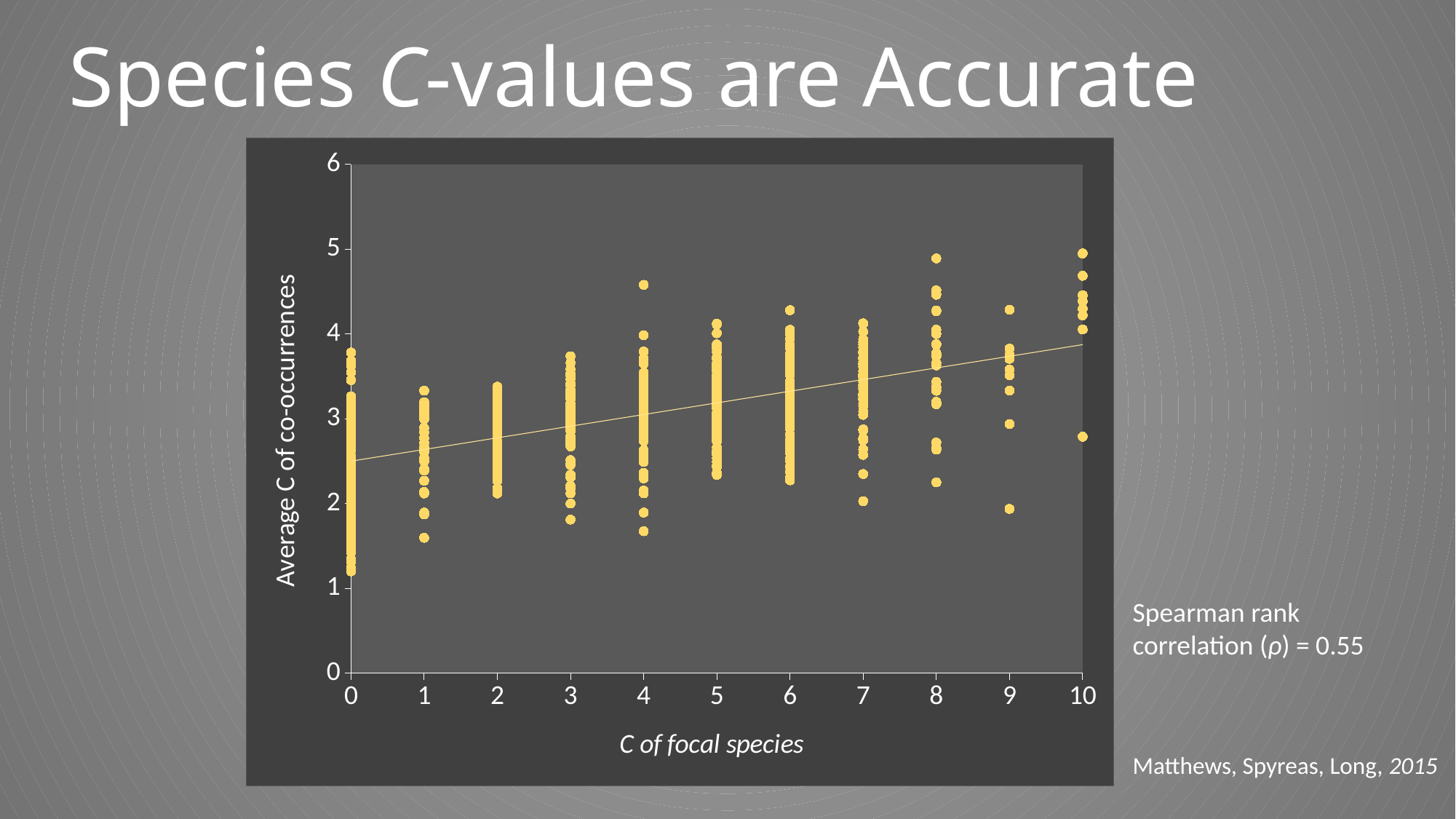
Is the lowest point at C of focal species = 0 greater or less than 2? less What is the label of the y axis of the chart? Average C of co-occurrences Is the highest point at C of focal species = 1 greater or less than 4? less What is the label of the x axis of the chart? C of focal species Is the highest point at C of focal species = 10 greater or less than 4? greater How many distinct C of focal species values (x-axis ticks) are shown on the chart? 11 Do the values of Average C of co-occurrences generally rise or fall as C of focal species increases? rise What kind of chart is shown on the slide? scatter plot What is the maximum value shown on the y axis of the chart? 6